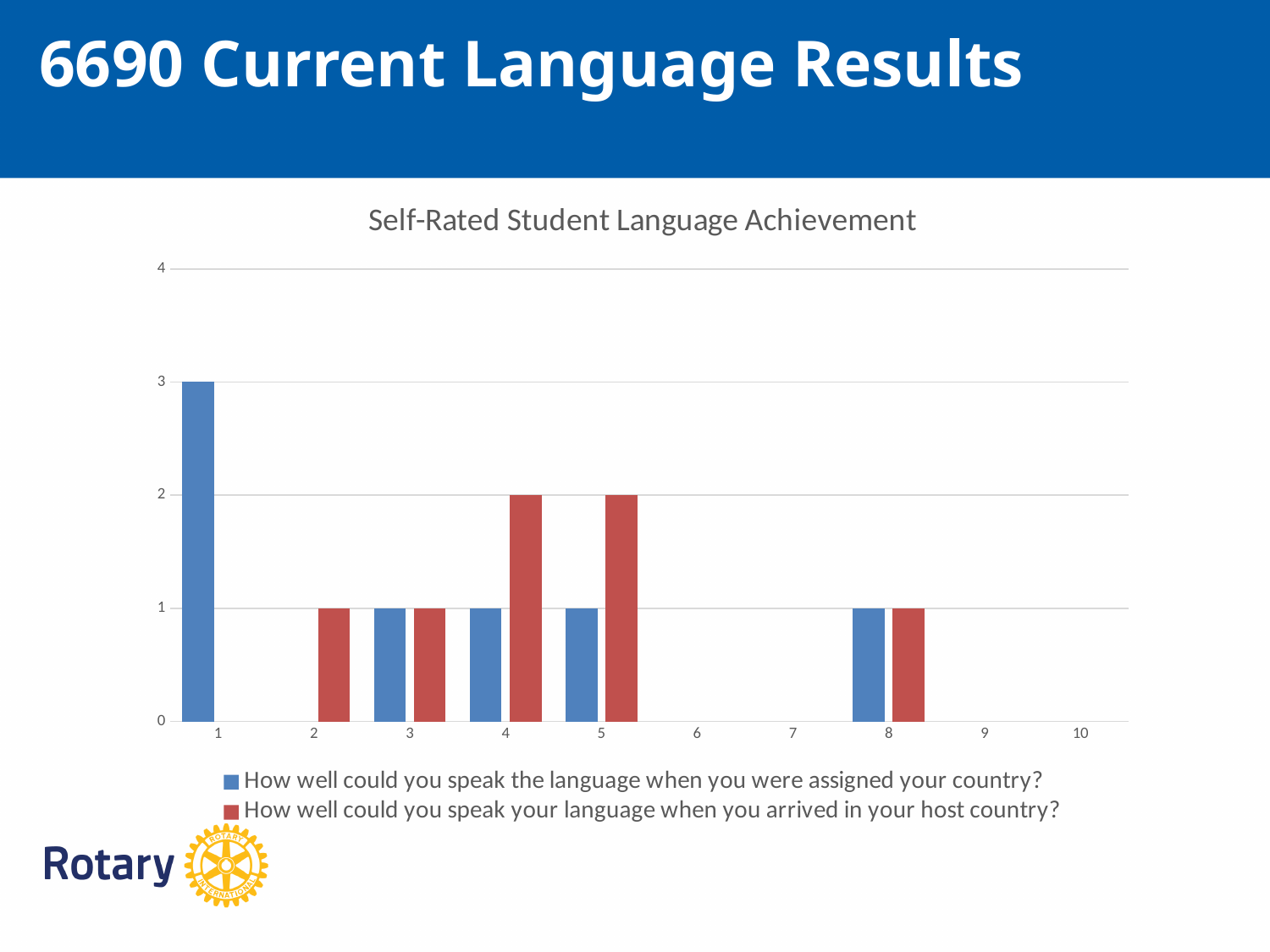
How many categories are shown on the x axis? 10 Is the value for category 1 in the series 'How well could you speak the language when you were assigned your country?' greater or less than 2? greater Which category has the highest value in the series 'How well could you speak the language when you were assigned your country?'? 1 What colour are the bars for the series 'How well could you speak your language when you arrived in your host country?'? red What is the value for category 1 in the series 'How well could you speak the language when you were assigned your country?'? 3 What is the title of the chart? Self-Rated Student Language Achievement At category 4, which series has the larger value? How well could you speak your language when you arrived in your host country? What kind of chart is shown on the slide? bar chart How many series does the legend list? 2 What is the difference between the two series at category 5? 1 What is the value for category 8 in the series 'How well could you speak the language when you were assigned your country?'? 1 What is the value for category 4 in the series 'How well could you speak your language when you arrived in your host country?'? 2